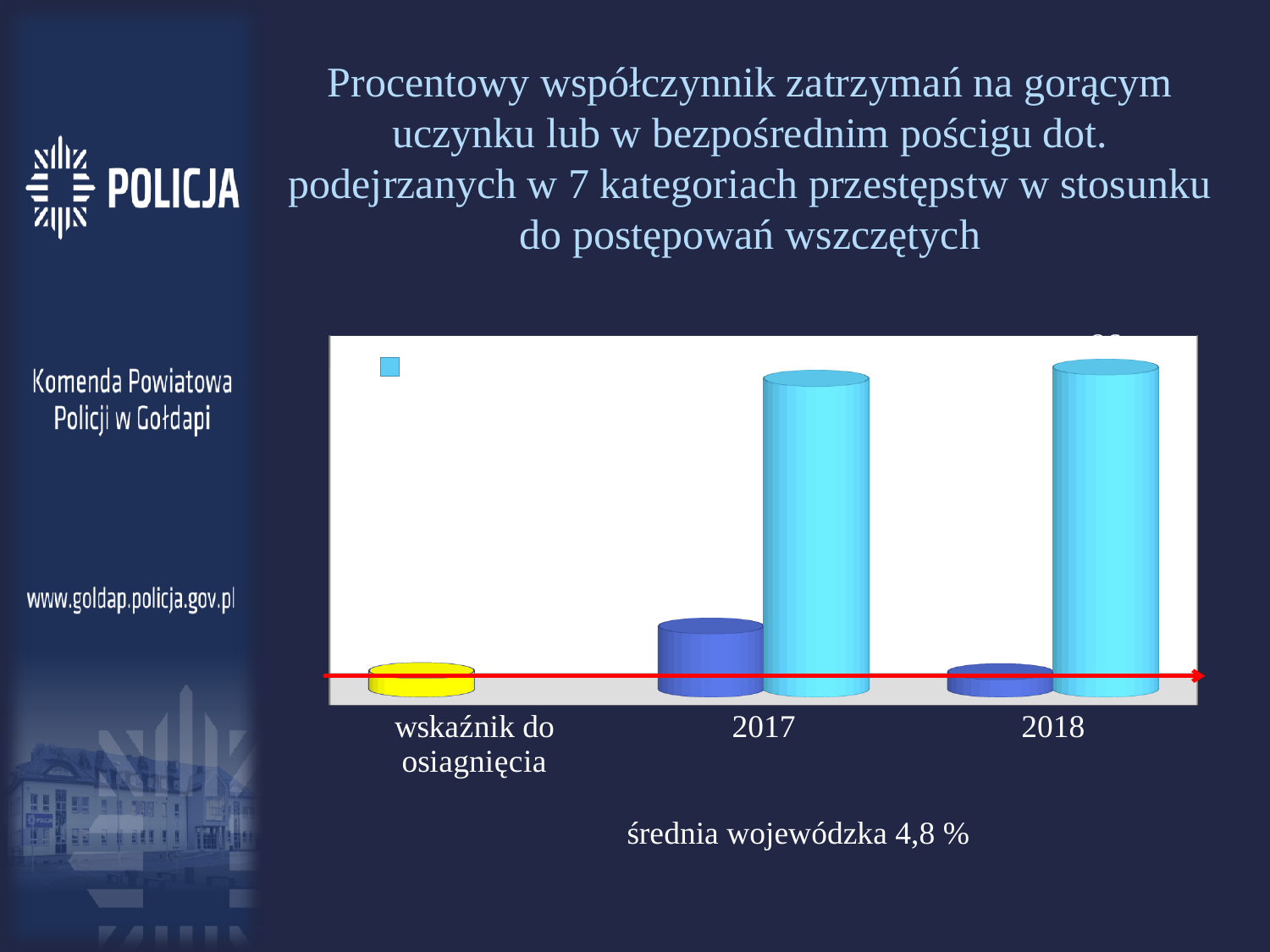
What value is given for 'średnia wojewódzka' below the chart? 4,8 % Which year has the taller dark blue bar, 2017 or 2018? 2017 What kind of chart is shown on the slide? bar chart Which categories are labelled on the x axis of the chart? wskaźnik do osiagnięcia, 2017, 2018 How many categories are shown along the x axis of the chart? 3 What colour is the bar for the category 'wskaźnik do osiagnięcia'? yellow Is the dark blue bar for 2017 taller or shorter than the dark blue bar for 2018? taller